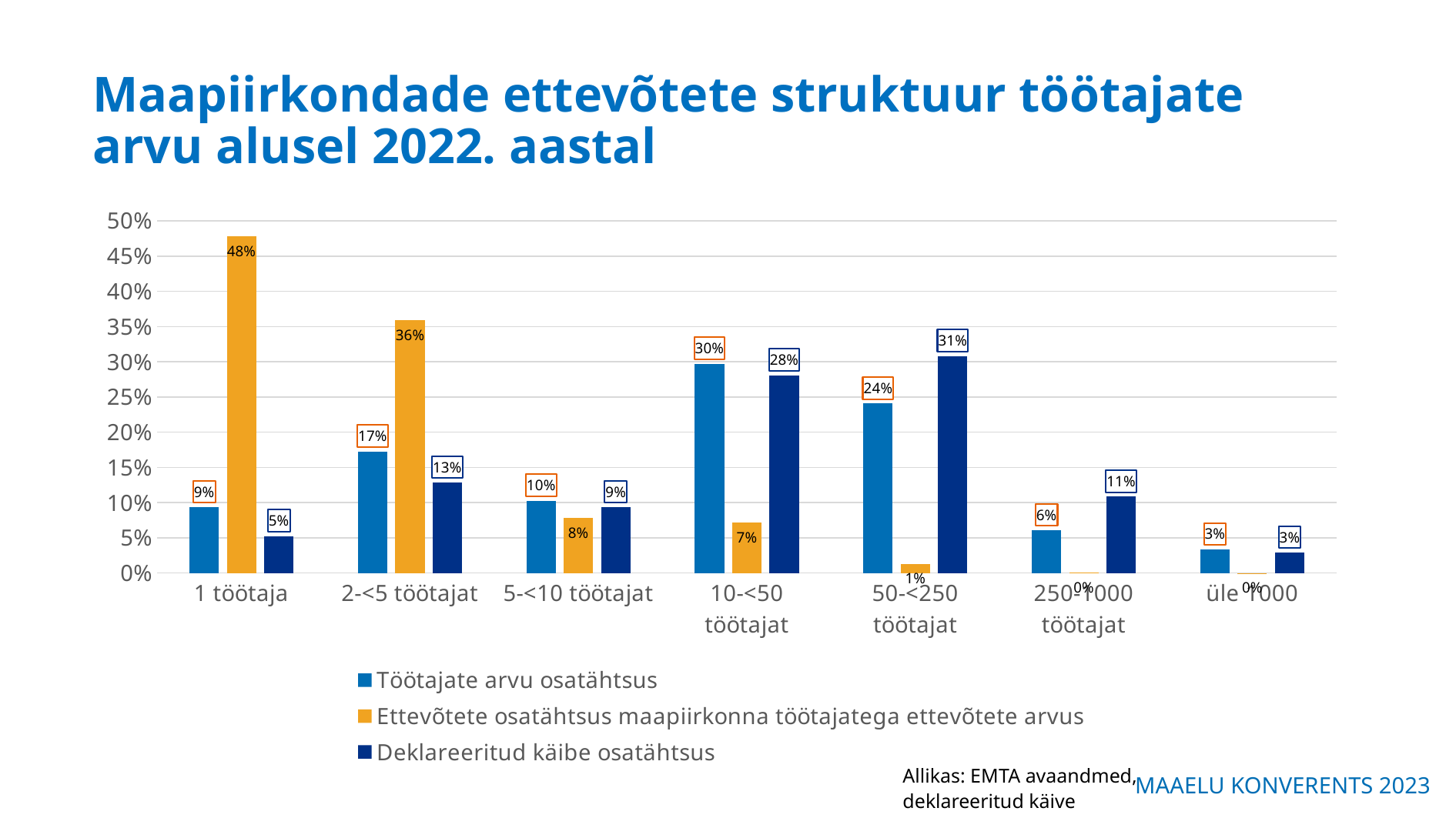
Is the value of 'Ettevõtete osatähtsus maapiirkonna töötajatega ettevõtete arvus' for '1 töötaja' greater or less than 45%? greater Which category has the lowest value for 'Töötajate arvu osatähtsus'? üle 1000 Which category has the highest value for 'Ettevõtete osatähtsus maapiirkonna töötajatega ettevõtete arvus'? 1 töötaja What is the value of 'Ettevõtete osatähtsus maapiirkonna töötajatega ettevõtete arvus' for the '2-<5 töötajat' category? 36% What is the value of 'Deklareeritud käibe osatähtsus' for the '50-<250 töötajat' category? 31% How many categories are shown on the x axis? 7 What is the value of 'Töötajate arvu osatähtsus' for the '1 töötaja' category? 9% What kind of chart is shown on the slide? bar chart How many series does the legend list? 3 What is the title of the chart? Maapiirkondade ettevõtete struktuur töötajate arvu alusel 2022. aastal What is the difference between the 'Töötajate arvu osatähtsus' value and the 'Deklareeritud käibe osatähtsus' value for the '10-<50 töötajat' category? 2% For the '2-<5 töötajat' category, which is larger: 'Töötajate arvu osatähtsus' or 'Deklareeritud käibe osatähtsus'? Töötajate arvu osatähtsus